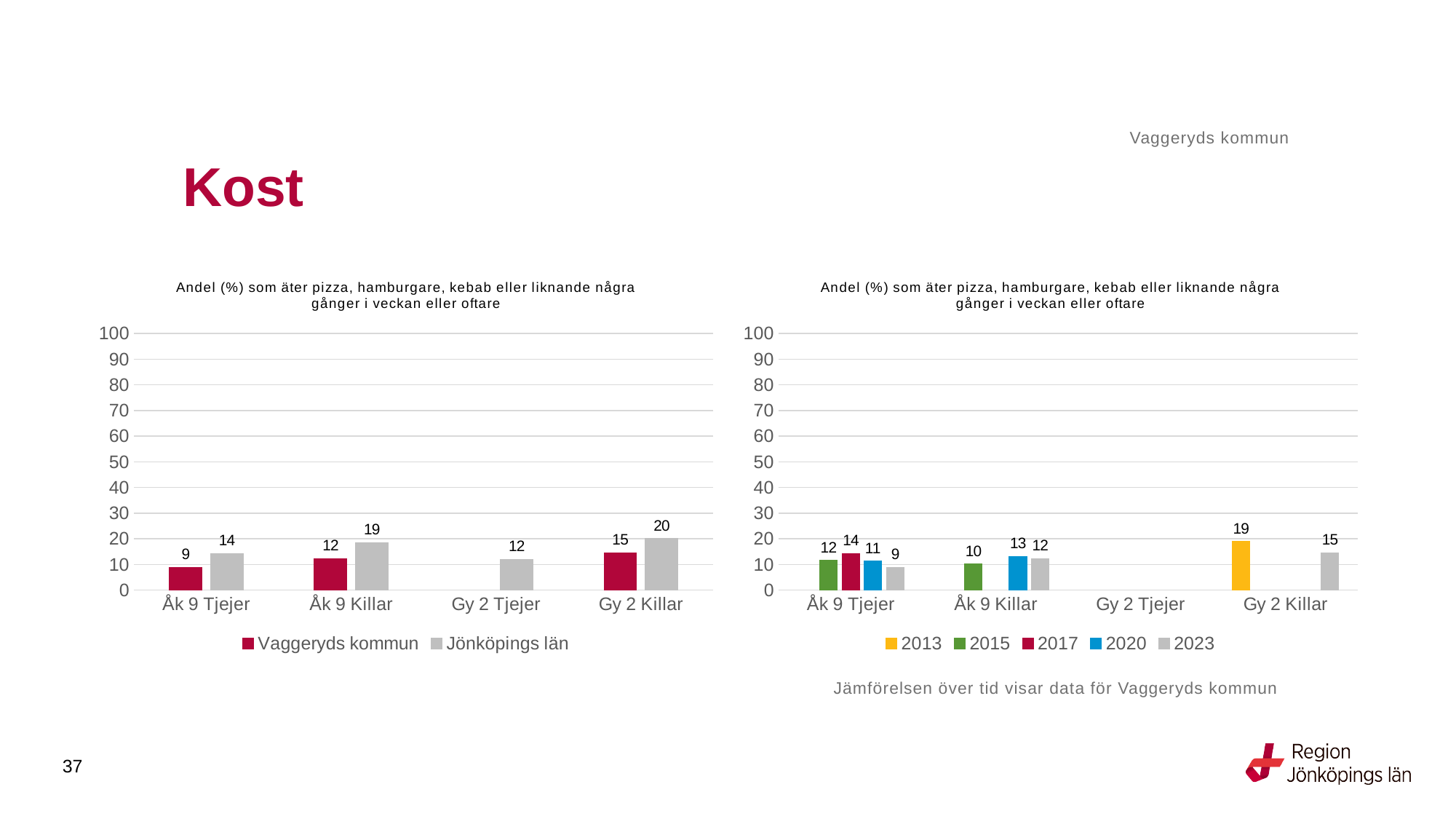
In the right chart, which is larger for Gy 2 Killar: the 2013 value or the 2023 value? 2013 In the right chart, how many series does the legend list? 5 In the left chart, what is the value for Jönköpings län for Gy 2 Killar? 20 In the left chart, how many series does the legend list? 2 In the right chart, which year has the lowest value for Åk 9 Tjejer? 2023 In the left chart, what is the difference between Jönköpings län and Vaggeryds kommun for Åk 9 Killar? 7 In the right chart, what is the difference between the 2017 and 2023 values for Åk 9 Tjejer? 5 In the right chart, what is the value for 2013 for Gy 2 Killar? 19 In the right chart, what is the value for 2020 for Åk 9 Killar? 13 In the left chart, what is the value for Vaggeryds kommun for Åk 9 Tjejer? 9 What kind of chart is the right chart? Bar chart In the left chart, which category has the highest value for Jönköpings län? Gy 2 Killar